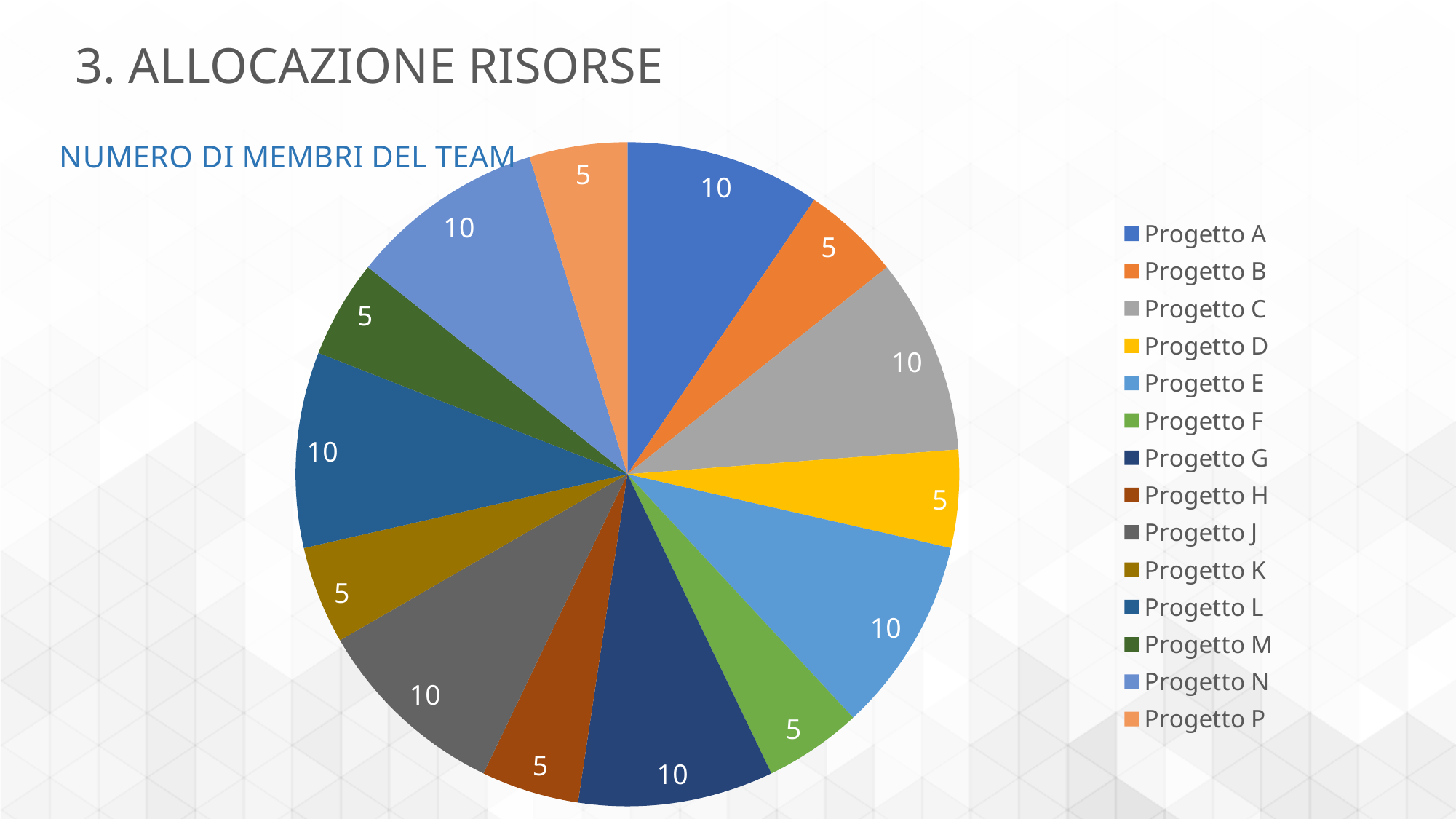
What is the value for Progetto K? 5 What is the value for Progetto N? 10 What is the value for Progetto D? 5 Which is larger, the value for Progetto C or the value for Progetto D? Progetto C What kind of chart is shown on the slide? pie chart What is the title of the chart? NUMERO DI MEMBRI DEL TEAM How many slices does the pie chart have? 14 What is the value for Progetto B? 5 What is the difference between the value for Progetto E and the value for Progetto F? 5 How many entries does the legend list? 14 What is the value for Progetto A? 10 What is the value for Progetto G? 10